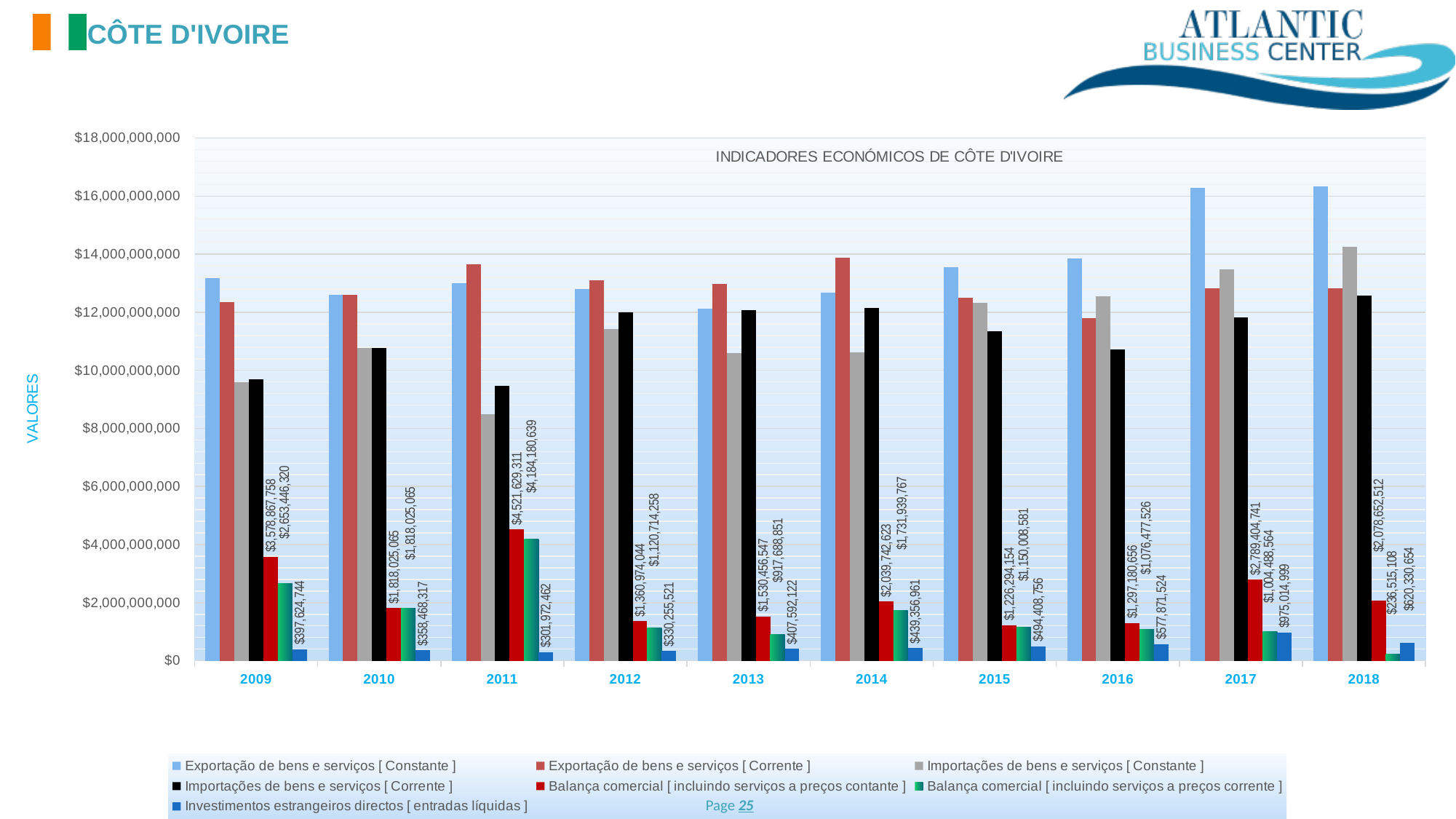
How many years are shown on the x axis of the chart? 10 Is the value of Exportação de bens e serviços [ Constante ] in 2018 greater or less than $16,000,000,000? greater What is the title of the chart? INDICADORES ECONÓMICOS DE CÔTE D'IVOIRE What is the value of Balança comercial [ incluindo serviços a preços corrente ] in 2014? $1,731,939,767 What is the value of Balança comercial [ incluindo serviços a preços contante ] in 2011? $4,521,629,311 In 2009, which is larger: Exportação de bens e serviços [ Corrente ] or Importações de bens e serviços [ Corrente ]? Exportação de bens e serviços [ Corrente ] In 2011, what is the difference between Balança comercial [ incluindo serviços a preços contante ] and Balança comercial [ incluindo serviços a preços corrente ]? $337,448,672 What kind of chart is shown on the slide? bar chart In which year is Balança comercial [ incluindo serviços a preços corrente ] lowest? 2018 What is the value of Investimentos estrangeiros directos [ entradas líquidas ] in 2017? $975,014,999 In which year is Investimentos estrangeiros directos [ entradas líquidas ] highest? 2017 How many series does the chart's legend list? 7